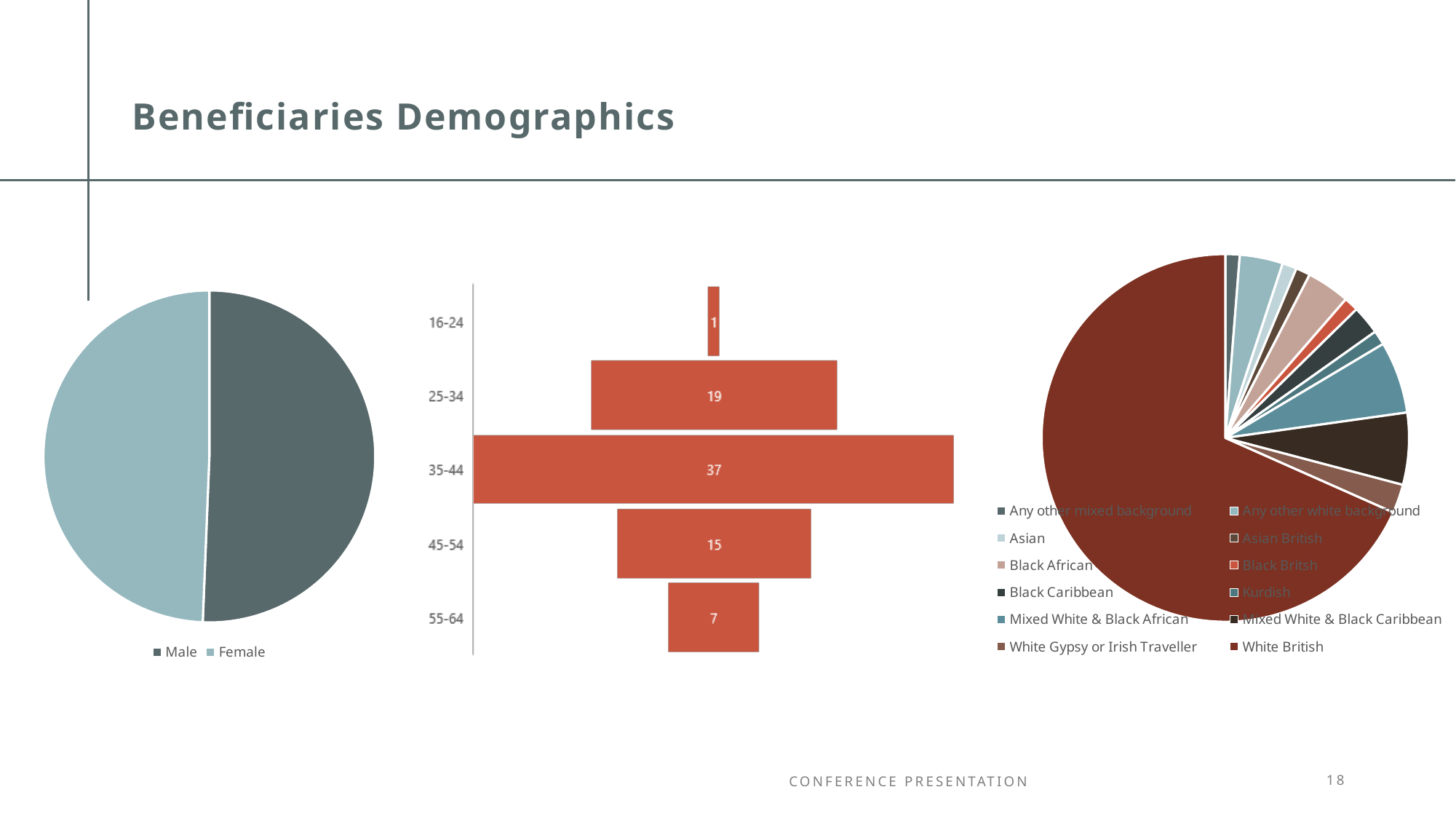
What kind of chart is the middle chart on the slide? Bar chart In the middle bar chart, what is the value for the 35-44 age group? 37 In the middle bar chart, what is the value for the 25-34 age group? 19 In the middle bar chart, which age group has the highest value? 35-44 In the middle bar chart, which age group has the lowest value? 16-24 In the middle bar chart, what is the value for the 55-64 age group? 7 How many categories does the legend of the right-hand pie chart list? 12 In the middle bar chart, which is larger, the value for 25-34 or the value for 45-54? 25-34 In the right-hand pie chart, which category has the largest slice? White British How many age groups are shown in the middle bar chart? 5 In the middle bar chart, what is the difference between the values for 35-44 and 25-34? 18 In the middle bar chart, what is the difference between the values for 45-54 and 55-64? 8